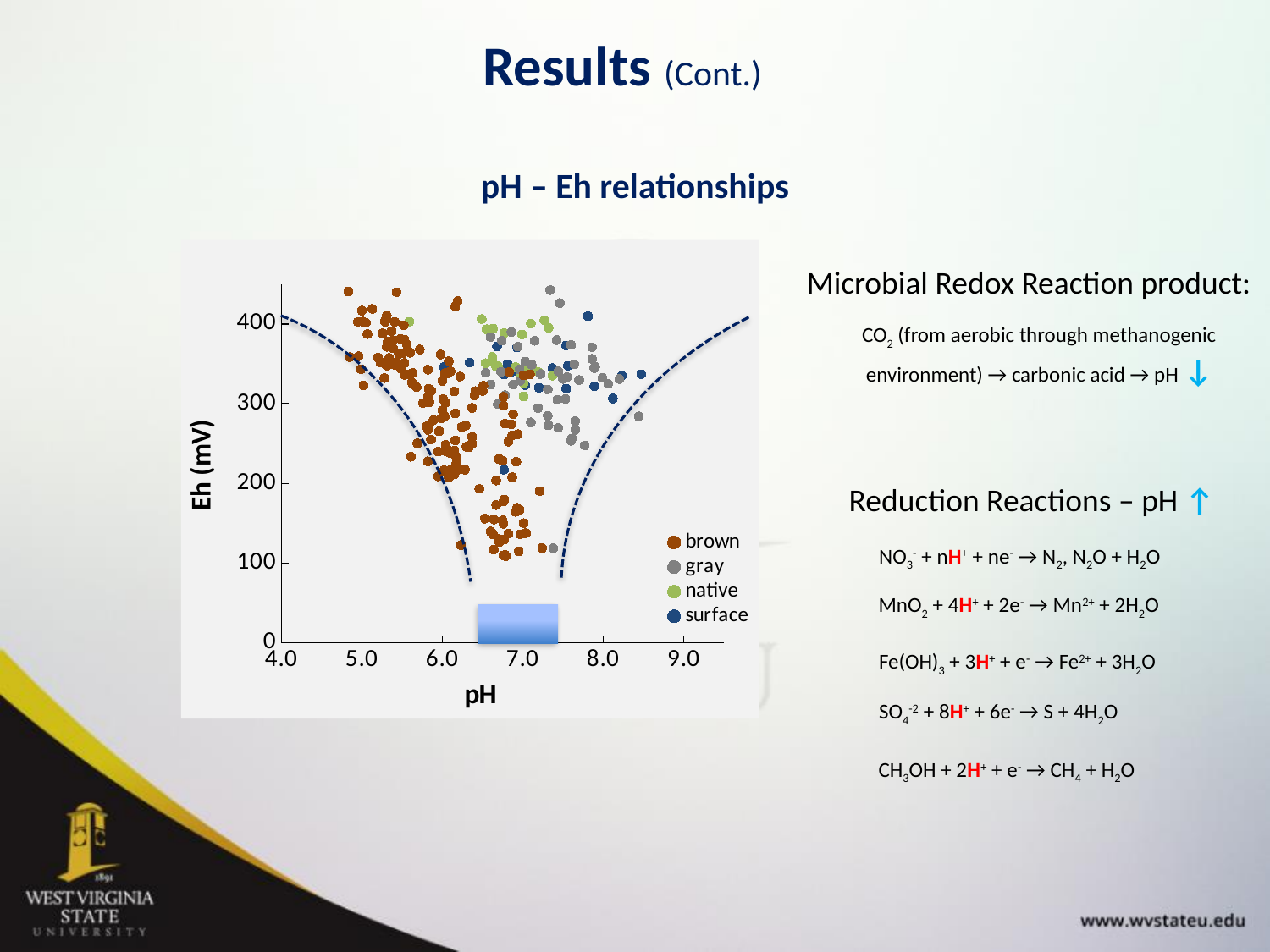
How many series does the chart legend list? 4 What are the series names listed in the chart legend? brown, gray, native, surface What kind of chart is shown on the slide? scatter chart What is the label of the vertical axis of the chart? Eh (mV) Are the native (green) points at Eh greater or less than 300? greater Are the gray points mostly at pH greater or less than 6.0? greater Are the brown points mostly at pH greater or less than 7.0? less Which series, brown or gray, has its points at lower pH values? brown